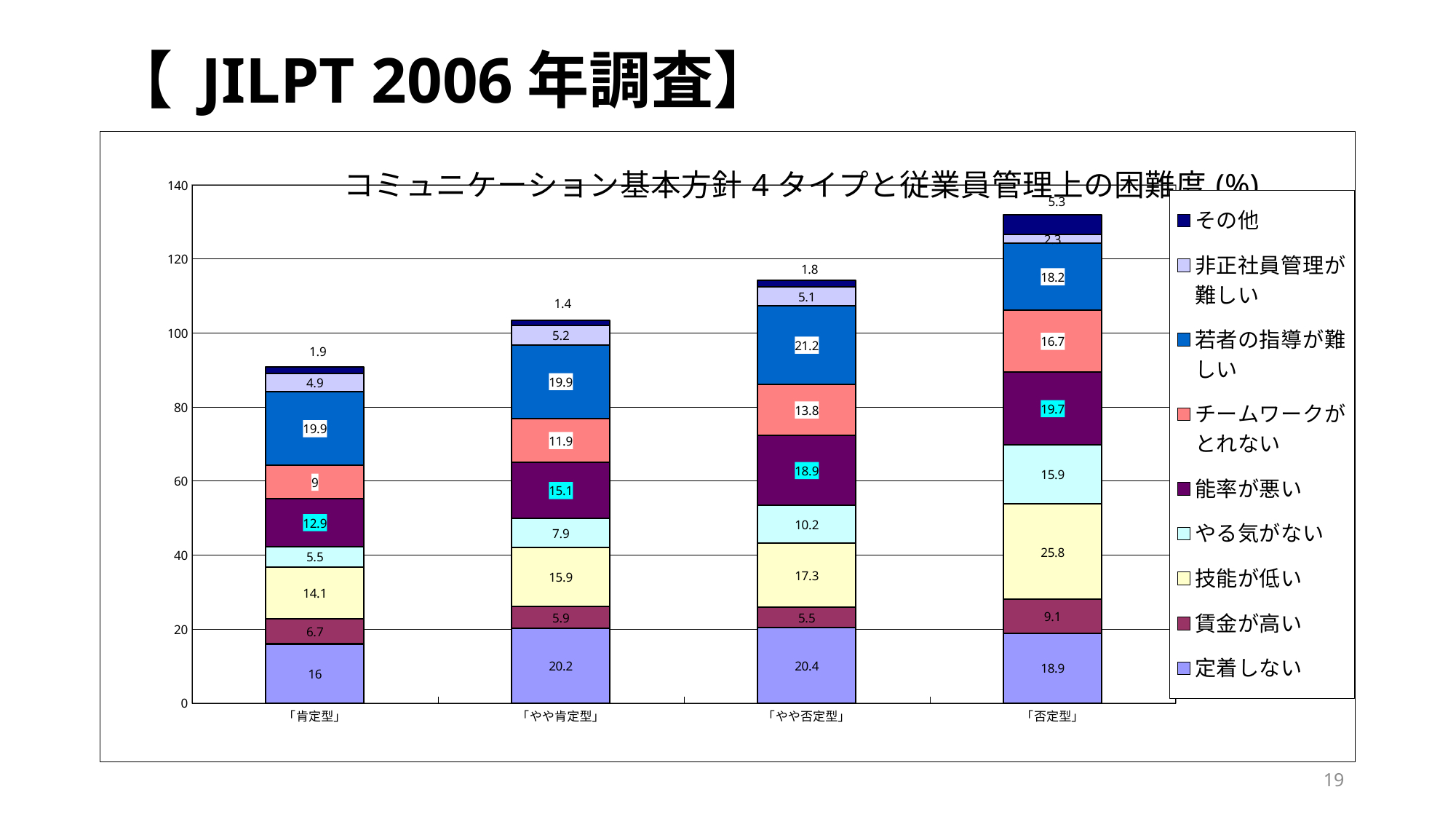
What kind of chart is shown on the slide? stacked bar chart How many categories are shown on the x axis? 4 What is the value of 定着しない for 「やや肯定型」? 20.2 What is the value of 技能が低い for 「否定型」? 25.8 Which is larger: チームワークがとれない for 「やや肯定型」 or for 「やや否定型」? 「やや否定型」 Which category has the lowest value for やる気がない? 「肯定型」 What is the value of 若者の指導が難しい for 「やや否定型」? 21.2 What is the difference between the 能率が悪い values for 「否定型」 and 「肯定型」? 6.8 Which category has the highest value for 技能が低い? 「否定型」 How many series does the legend list? 9 Is the total height of the 「否定型」 bar greater or less than 120? greater Do the total bar heights rise or fall from 「肯定型」 to 「否定型」? rise